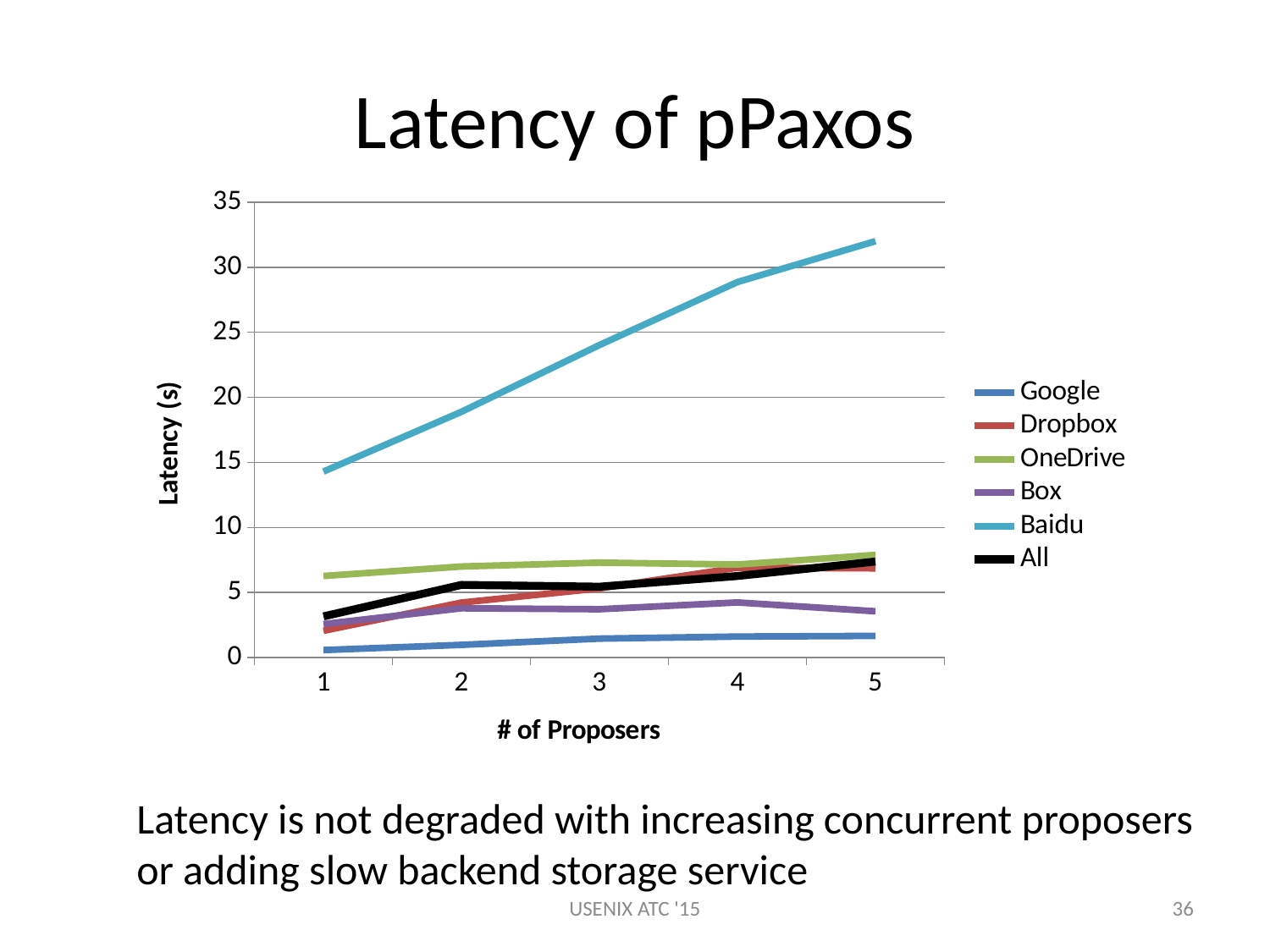
Which series has the highest latency at 5 proposers? Baidu Is the latency for Google at 5 proposers greater or less than 5? less Is the latency for Baidu at 5 proposers greater or less than 30? greater What is the title of the y axis? Latency (s) How many values of # of Proposers are plotted along the x axis? 5 What is the title of the x axis? # of Proposers Is the latency for Baidu at 1 proposer greater or less than 10? greater Does the latency for Baidu rise or fall as the number of proposers increases from 1 to 5? rise What kind of chart is shown on the slide? line chart Which series has the lowest latency at 5 proposers? Google How many series does the legend list? 6 At 1 proposer, which has the higher latency, OneDrive or Google? OneDrive